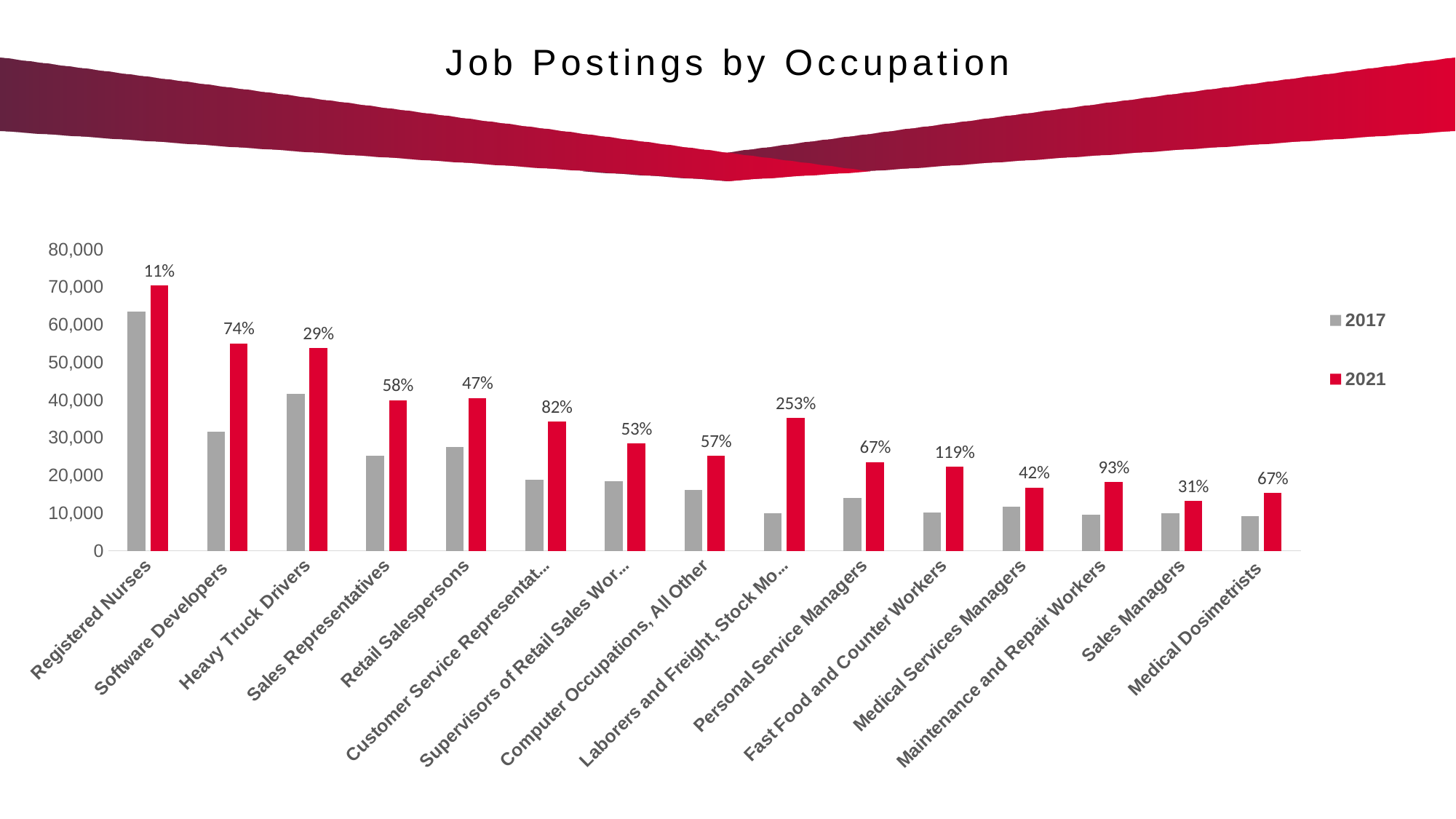
For Heavy Truck Drivers, which is larger, the 2017 value or the 2021 value? 2021 What percentage label is shown above the 2021 bar for Sales Managers? 31% How many occupations are shown on the x axis? 15 What percentage label is shown above the 2021 bar for Software Developers? 74% What kind of chart is shown on the slide? Bar chart Is the 2021 value for Registered Nurses greater or less than 60,000? greater How many series does the legend list? 2 Which occupation has the lowest percentage label shown above its 2021 bar? Registered Nurses (11%) Is the 2021 value for Medical Dosimetrists greater or less than 20,000? less What percentage label is shown above the 2021 bar for Fast Food and Counter Workers? 119% Which occupation has the highest percentage label shown above its 2021 bar? Laborers and Freight, Stock Mo... (253%) Which occupation has the tallest 2021 bar? Registered Nurses